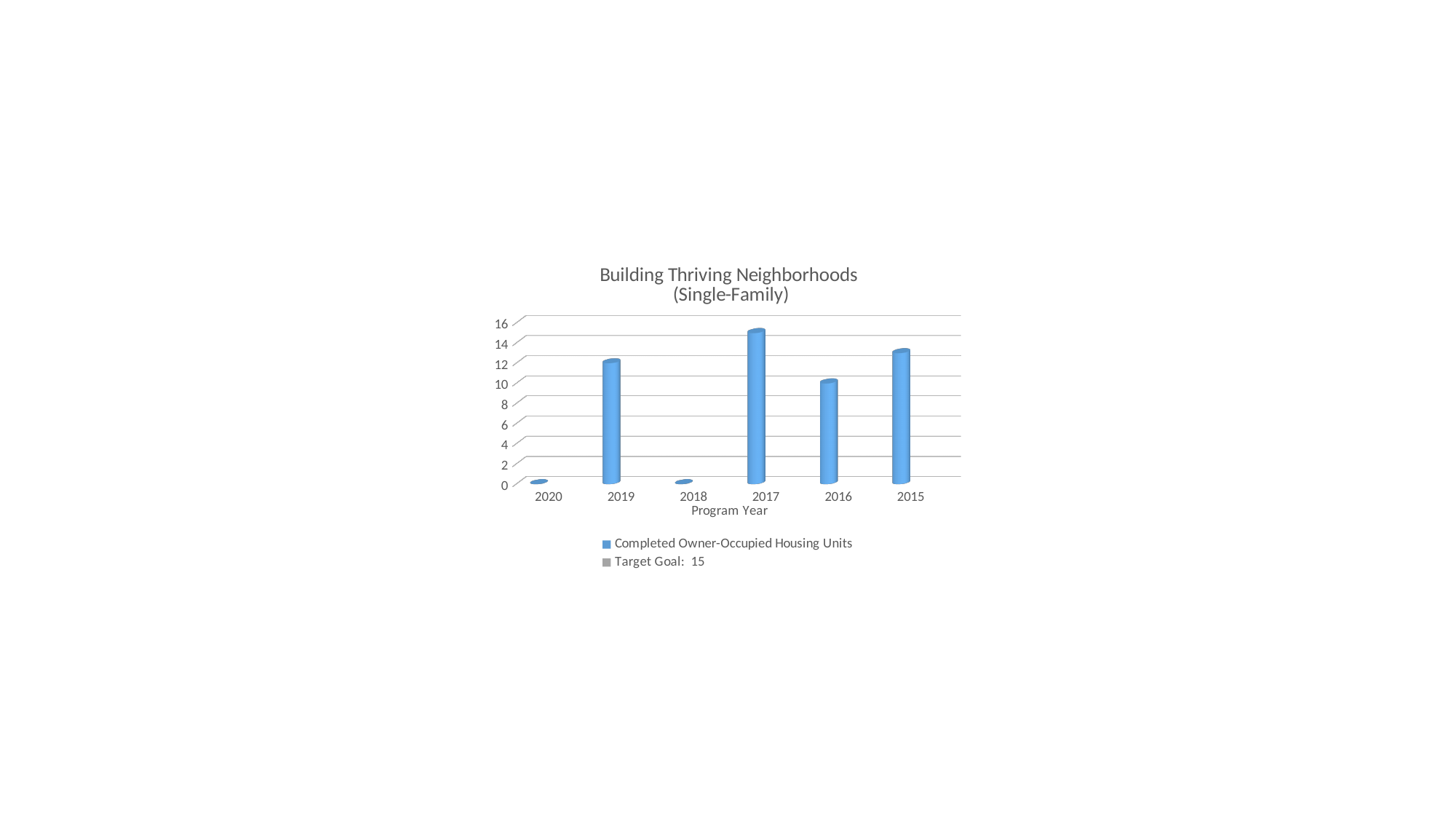
What is the title of the chart? Building Thriving Neighborhoods (Single-Family) What is the value for completed owner-occupied housing units in 2020? 0 What is the value for completed owner-occupied housing units in 2016? 10 How many series does the legend list? 2 What is the value for completed owner-occupied housing units in 2019? 12 Which is larger, the value for 2019 or the value for 2016? 2019 What is the difference between the values for 2019 and 2016? 2 How many program years are shown on the x axis? 6 Is the value for 2015 greater or less than 12? greater Which program year has the highest number of completed owner-occupied housing units? 2017 What type of chart is shown on the slide? Bar chart Is the value for 2017 greater or less than 14? greater